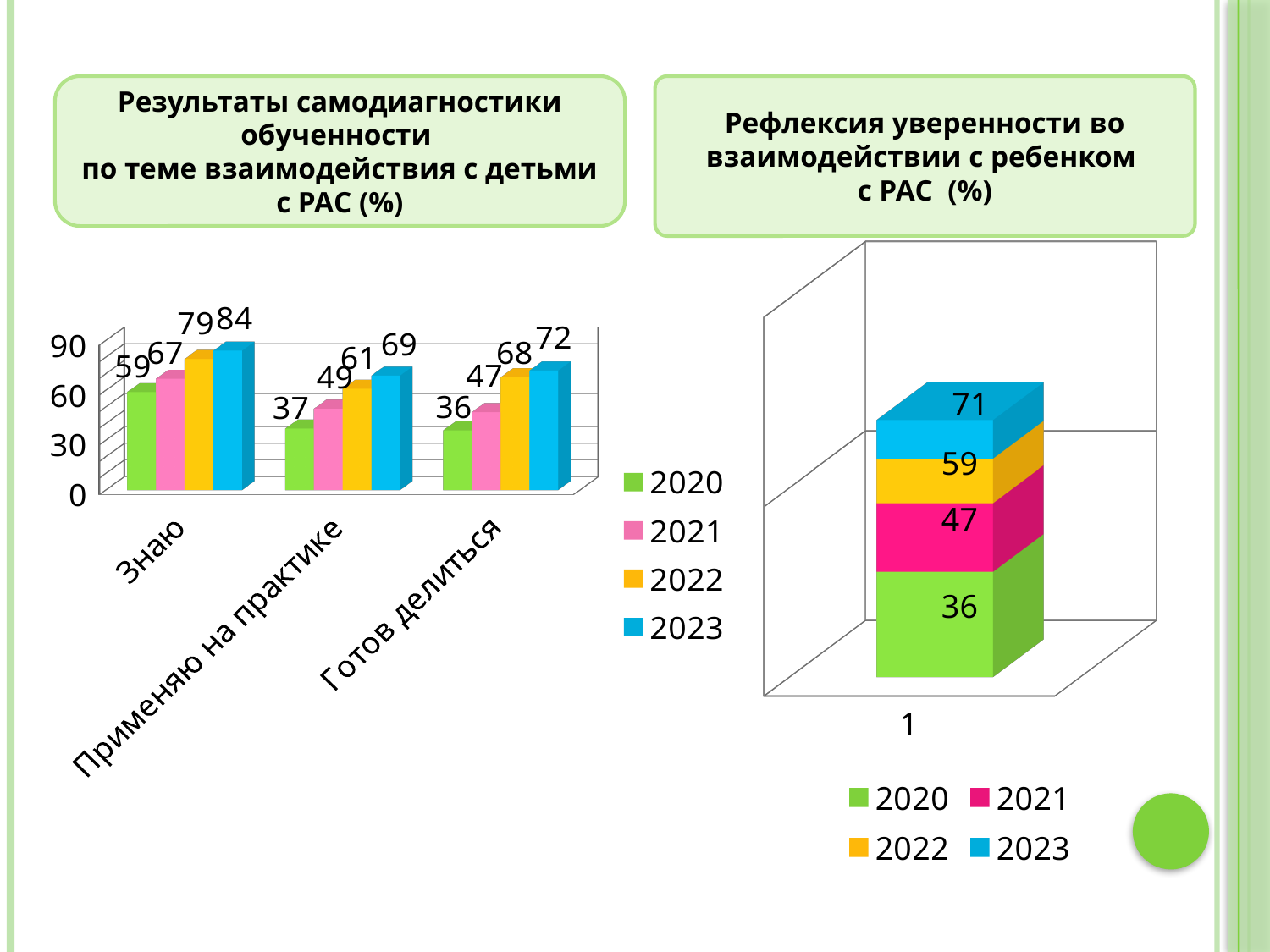
In the left chart (Результаты самодиагностики обученности), how many series does the legend list? 4 In the left chart (Результаты самодиагностики обученности), do the values for Применяю на практике rise or fall from 2020 to 2023? rise In the left chart (Результаты самодиагностики обученности), what is the value for 2023 in the category Знаю? 84 What kind of chart is the right chart (Рефлексия уверенности во взаимодействии с ребенком с РАС)? stacked bar chart In the right chart (Рефлексия уверенности во взаимодействии с ребенком с РАС), what is the value for 2021? 47 In the left chart (Результаты самодиагностики обученности), what is the value for 2022 in the category Готов делиться? 68 In the left chart (Результаты самодиагностики обученности), which category has the highest value for 2023? Знаю In the left chart (Результаты самодиагностики обученности), what is the value for 2020 in the category Применяю на практике? 37 In the right chart (Рефлексия уверенности во взаимодействии с ребенком с РАС), what is the total of the stacked bar? 213 In the left chart (Результаты самодиагностики обученности), which category has the lowest value for 2020? Готов делиться In the left chart (Результаты самодиагностики обученности), what is the difference between the 2023 and 2020 values for Знаю? 25 In the left chart (Результаты самодиагностики обученности), how many categories are shown on the x axis? 3